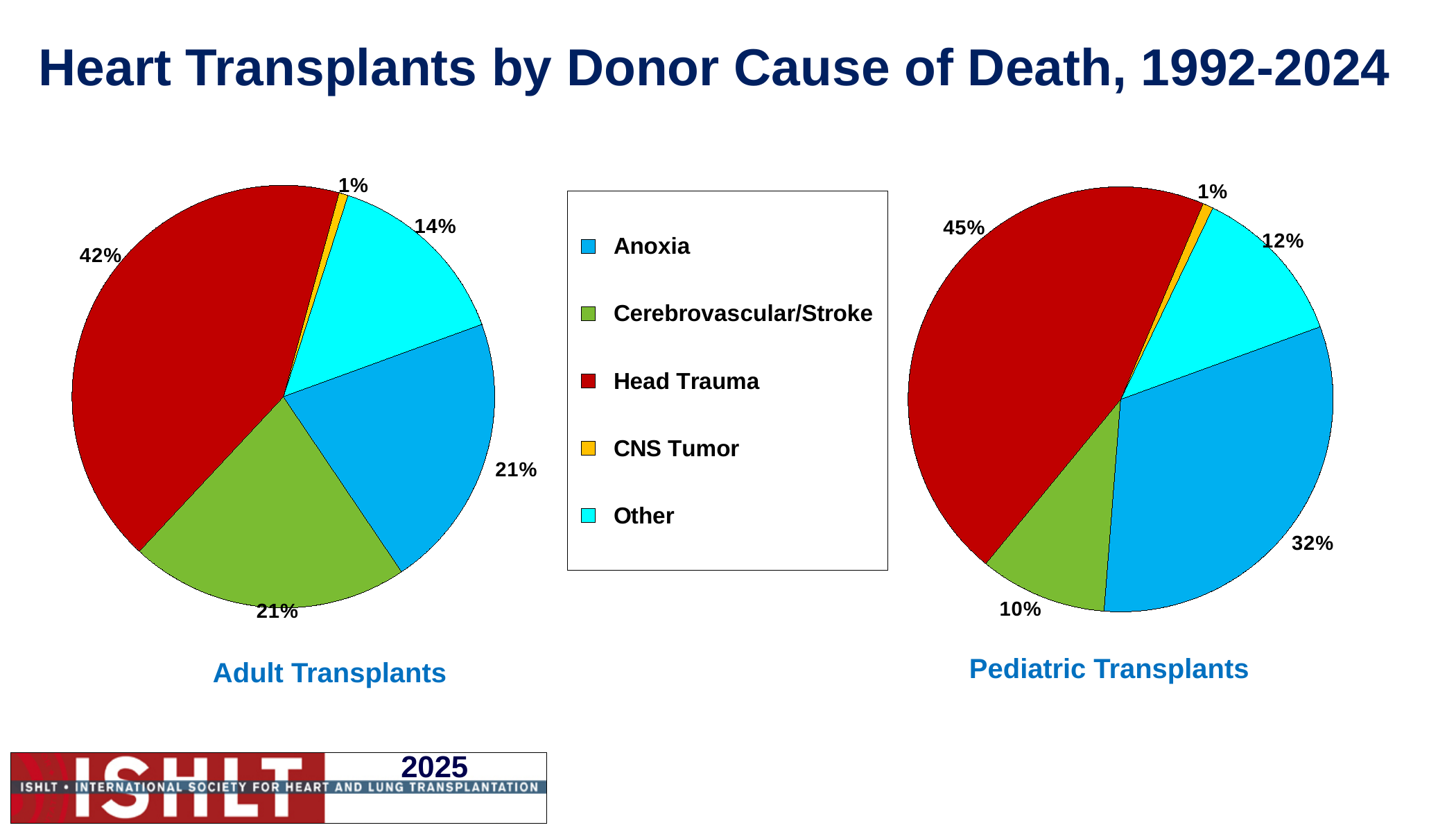
In the Adult Transplants pie chart, what share is labelled Other? 14% Is the Anoxia share larger in the Adult Transplants chart or the Pediatric Transplants chart? Pediatric Transplants In the Pediatric Transplants pie chart, what is the combined share of Anoxia and Cerebrovascular/Stroke? 42% In the Pediatric Transplants pie chart, what share of donors died of Anoxia? 32% In the Adult Transplants pie chart, what share of donors died of Head Trauma? 42% In the Pediatric Transplants pie chart, which cause of death has the smallest share? CNS Tumor In the Adult Transplants pie chart, which cause of death has the largest share? Head Trauma What is the difference between the Head Trauma share in the Pediatric Transplants chart and the Head Trauma share in the Adult Transplants chart? 3% Which colour represents Head Trauma in the legend? Red In the Pediatric Transplants pie chart, what share is Cerebrovascular/Stroke? 10% How many causes of death does the legend list? 5 What type of chart is used for the Adult Transplants data? Pie chart